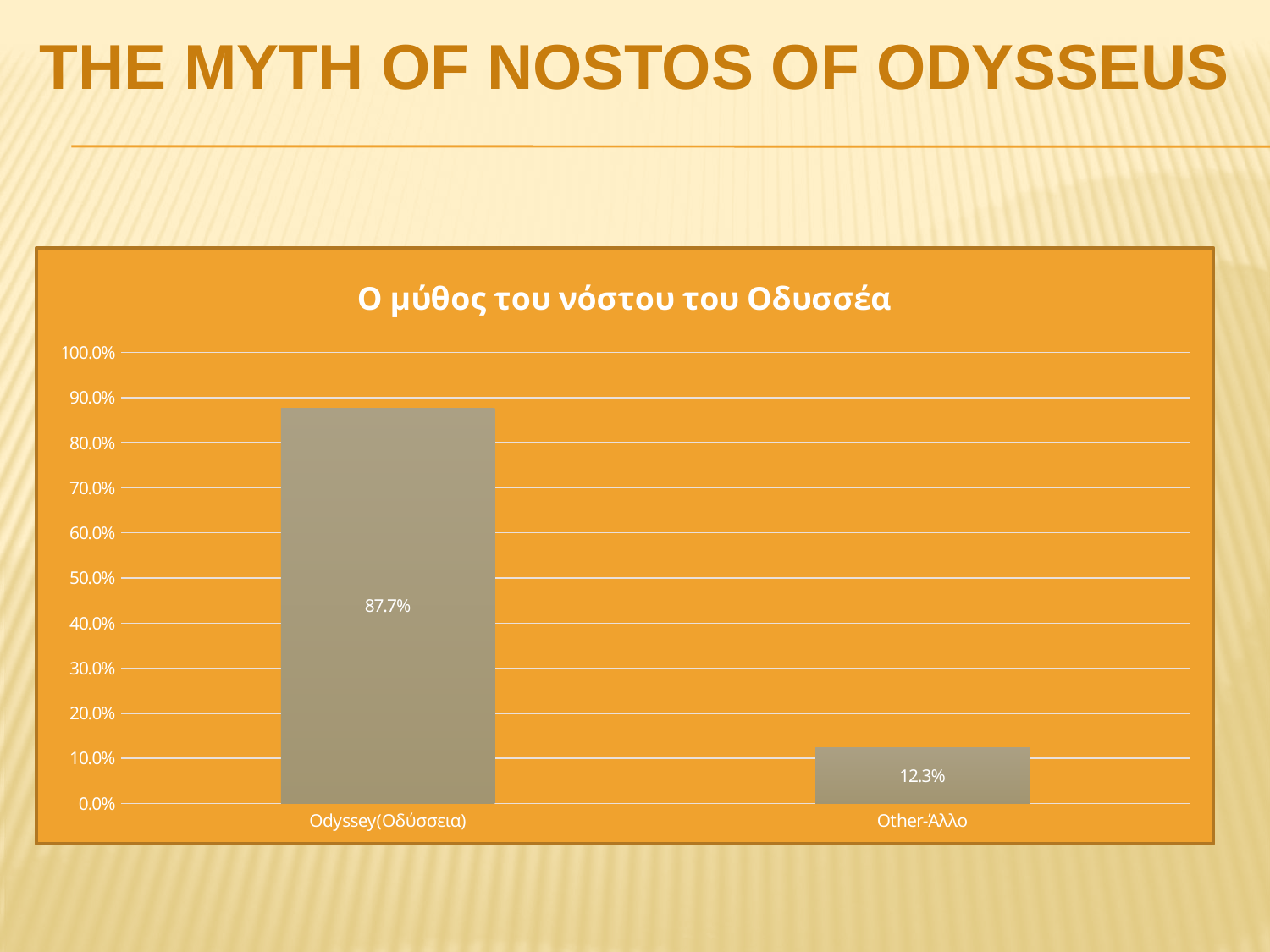
What is the title of the chart? Ο μύθος του νόστου του Οδυσσέα Is the value for Other-Άλλο greater or less than 20.0%? less What is the value for Other-Άλλο? 12.3% Is the value for Odyssey(Οδύσσεια) greater or less than 80.0%? greater Which category has the lowest value? Other-Άλλο What is the value for Odyssey(Οδύσσεια)? 87.7% What is the difference between the values for Odyssey(Οδύσσεια) and Other-Άλλο? 75.4% What kind of chart is shown on the slide? bar chart Which is larger, the value for Odyssey(Οδύσσεια) or the value for Other-Άλλο? Odyssey(Οδύσσεια) Which category has the highest value? Odyssey(Οδύσσεια) How many categories are shown on the x axis? 2 What is the highest value shown on the y axis? 100.0%